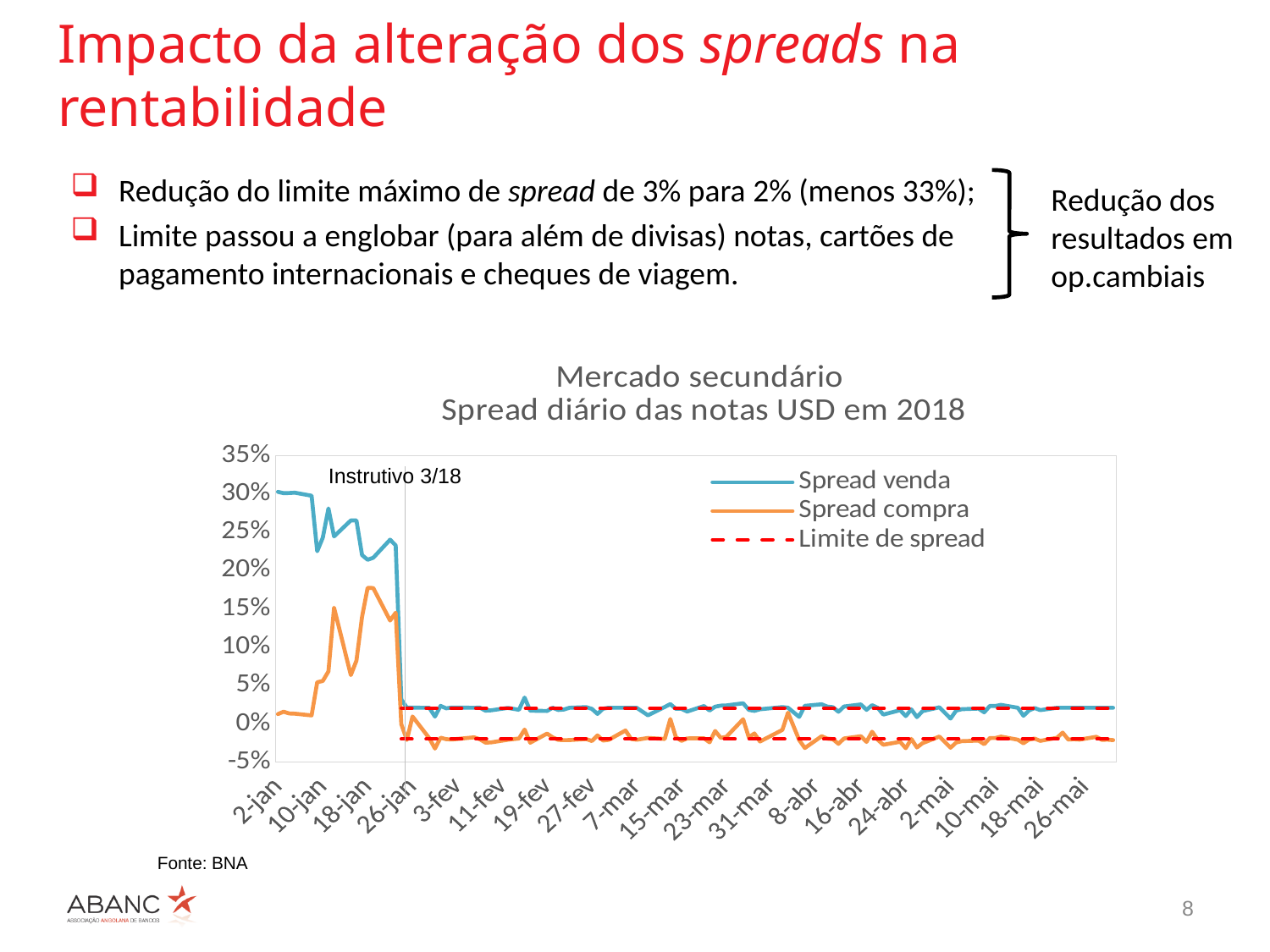
Is the value of Spread compra on 2-jan greater or less than 5%? less Does the Spread venda series rise or fall between mid-January and early February? Fall In January, which series has higher values: Spread venda or Spread compra? Spread venda Is the value of Spread compra on 26-mai greater or less than 5%? less How many series does the chart legend list? 3 What is the title of the chart? Mercado secundário Spread diário das notas USD em 2018 Is the peak value of Spread compra in January greater or less than 10%? greater Which series is shown with a red dashed line in the chart? Limite de spread What kind of chart is shown on the slide? Line chart What is the highest value shown on the vertical axis of the chart? 35%